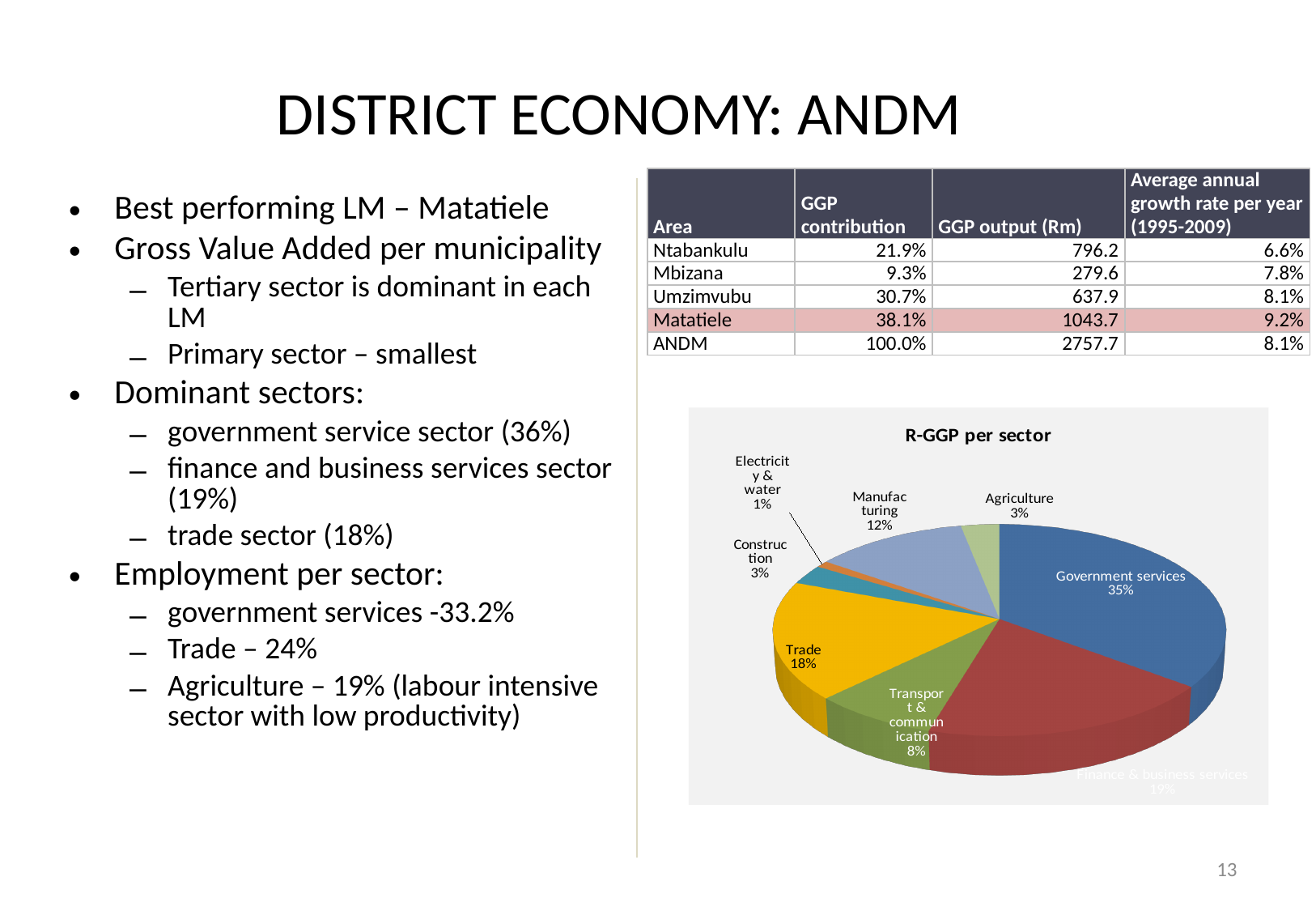
What share of the pie does Finance & business services have? 19% What share of the pie does Transport & communication have? 8% What kind of chart is shown on the slide? pie chart What share of the pie does Government services have? 35% Which sector has the largest slice of the pie? Government services How many sectors are shown in the pie chart? 8 What is the title of the chart? R-GGP per sector What is the difference in percentage points between Government services and Trade? 17 Which is larger, the Manufacturing slice or the Transport & communication slice? Manufacturing Which sector has the smallest slice of the pie? Electricity & water